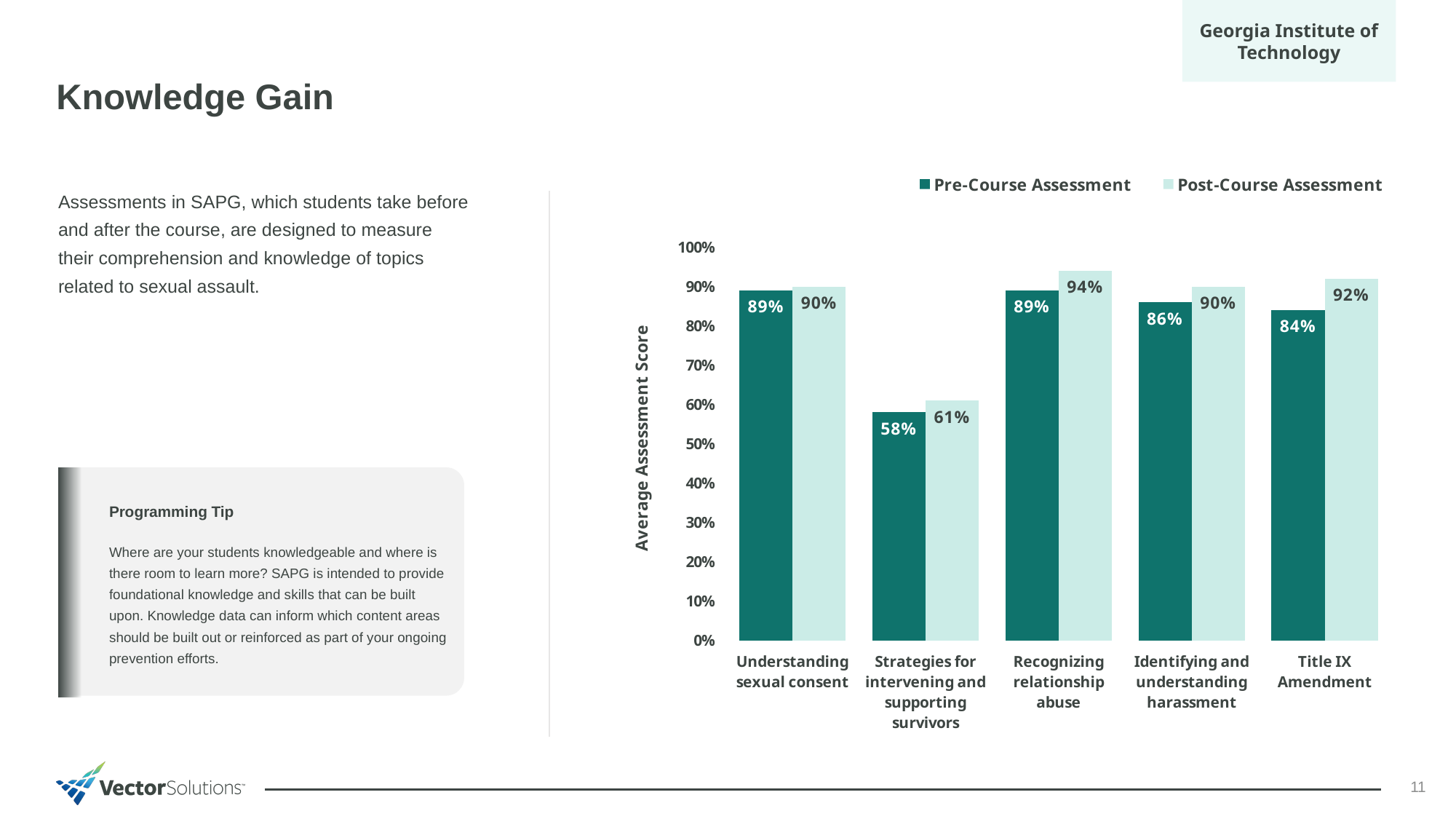
What is the difference between the Post-Course and Pre-Course Assessment scores for Title IX Amendment? 8% What is the difference between the Post-Course and Pre-Course Assessment scores for Identifying and understanding harassment? 4% What is the Pre-Course Assessment score for Title IX Amendment? 84% How many categories are shown on the x axis of the chart? 5 What is the Post-Course Assessment score for Recognizing relationship abuse? 94% How many series does the chart legend list? 2 What kind of chart is shown on the slide? Bar chart Which category has the lowest Pre-Course Assessment score? Strategies for intervening and supporting survivors Which category has the highest Post-Course Assessment score? Recognizing relationship abuse Which is larger: the Pre-Course Assessment score for Recognizing relationship abuse or the Pre-Course Assessment score for Title IX Amendment? Recognizing relationship abuse Is the Post-Course Assessment score for Strategies for intervening and supporting survivors greater or less than 70%? less What is the Pre-Course Assessment score for Understanding sexual consent? 89%